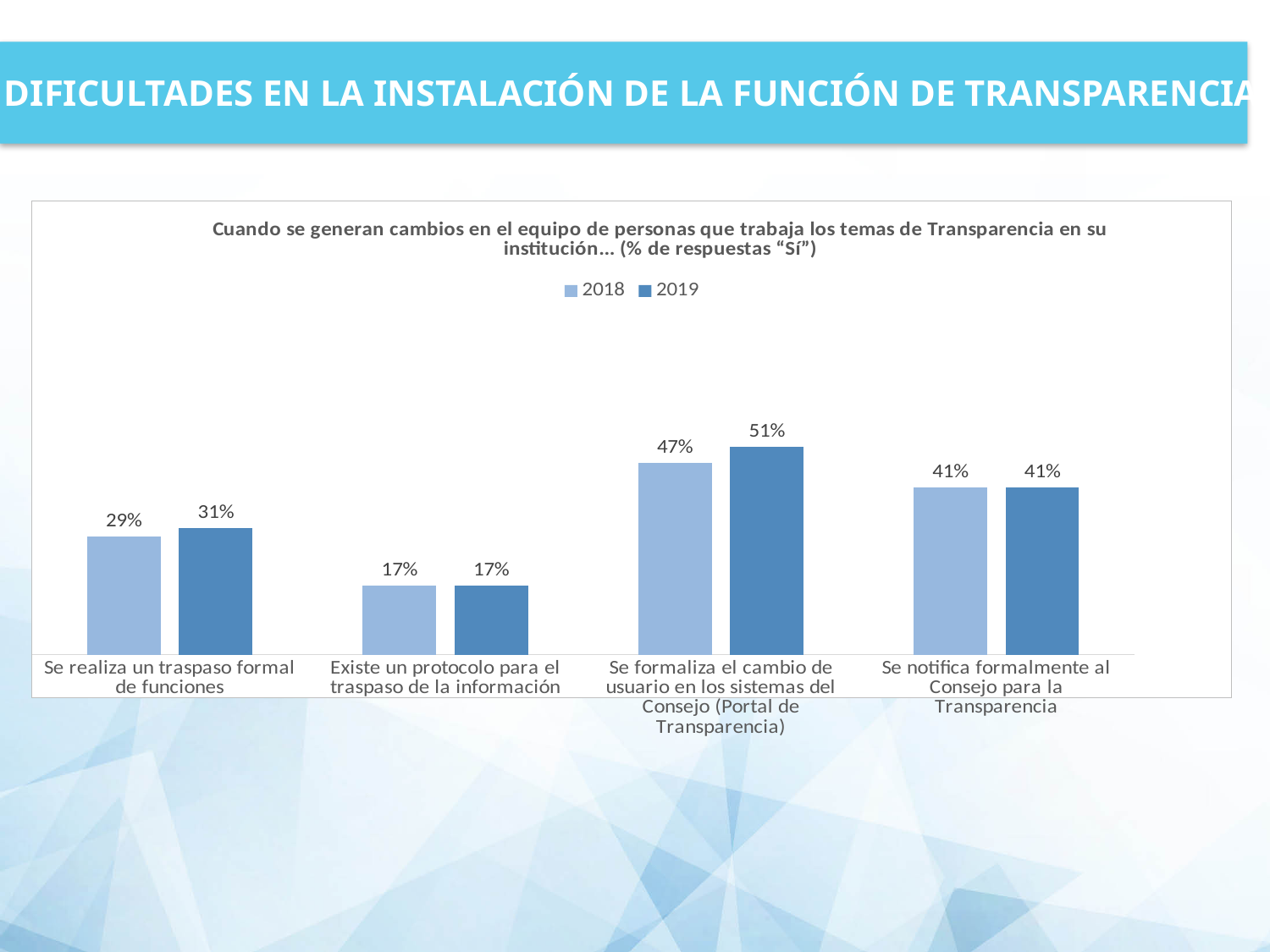
What is the difference between the 2019 and 2018 values for "Se formaliza el cambio de usuario en los sistemas del Consejo (Portal de Transparencia)"? 4% What is the 2018 value for "Existe un protocolo para el traspaso de la información"? 17% How many categories are shown on the x axis? 4 Which years are listed in the chart legend? 2018 and 2019 What is the 2019 value for "Se realiza un traspaso formal de funciones"? 31% What is the difference between the 2019 and 2018 values for "Se realiza un traspaso formal de funciones"? 2% What is the 2018 value for "Se formaliza el cambio de usuario en los sistemas del Consejo (Portal de Transparencia)"? 47% Which category has the lowest 2018 value? Existe un protocolo para el traspaso de la información Which category has the highest 2019 value? Se formaliza el cambio de usuario en los sistemas del Consejo (Portal de Transparencia) What kind of chart is shown on the slide? Bar chart Which is larger for "Se notifica formalmente al Consejo para la Transparencia": the 2018 value or the 2019 value? They are equal (41%) How many series does the legend list? 2